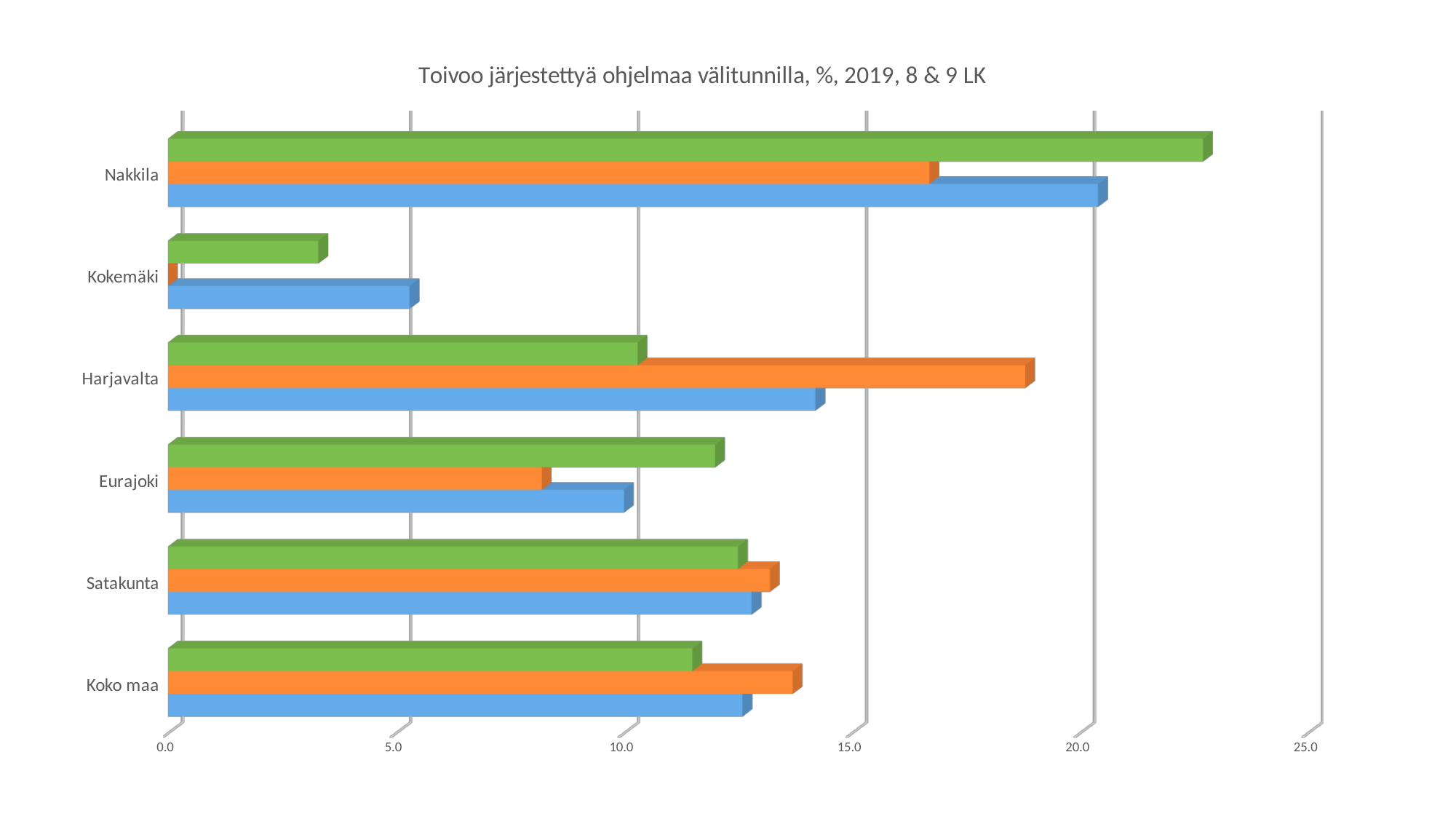
Which is larger, the green bar for Nakkila or the green bar for Harjavalta? Nakkila Which category has the longest green bar? Nakkila Which is larger for Kokemäki, the orange bar or the blue bar? the blue bar What kind of chart is shown on the slide? bar chart How many bars are plotted for each category in the chart? 3 Is the value of the orange bar for Harjavalta greater or less than 15? greater What is the title of the chart? Toivoo järjestettyä ohjelmaa välitunnilla, %, 2019, 8 & 9 LK Is the value of the green bar for Nakkila greater or less than 20? greater Is the value of the green bar for Kokemäki greater or less than 5? less Which category has the shortest orange bar? Kokemäki How many categories are shown on the vertical axis of the chart? 6